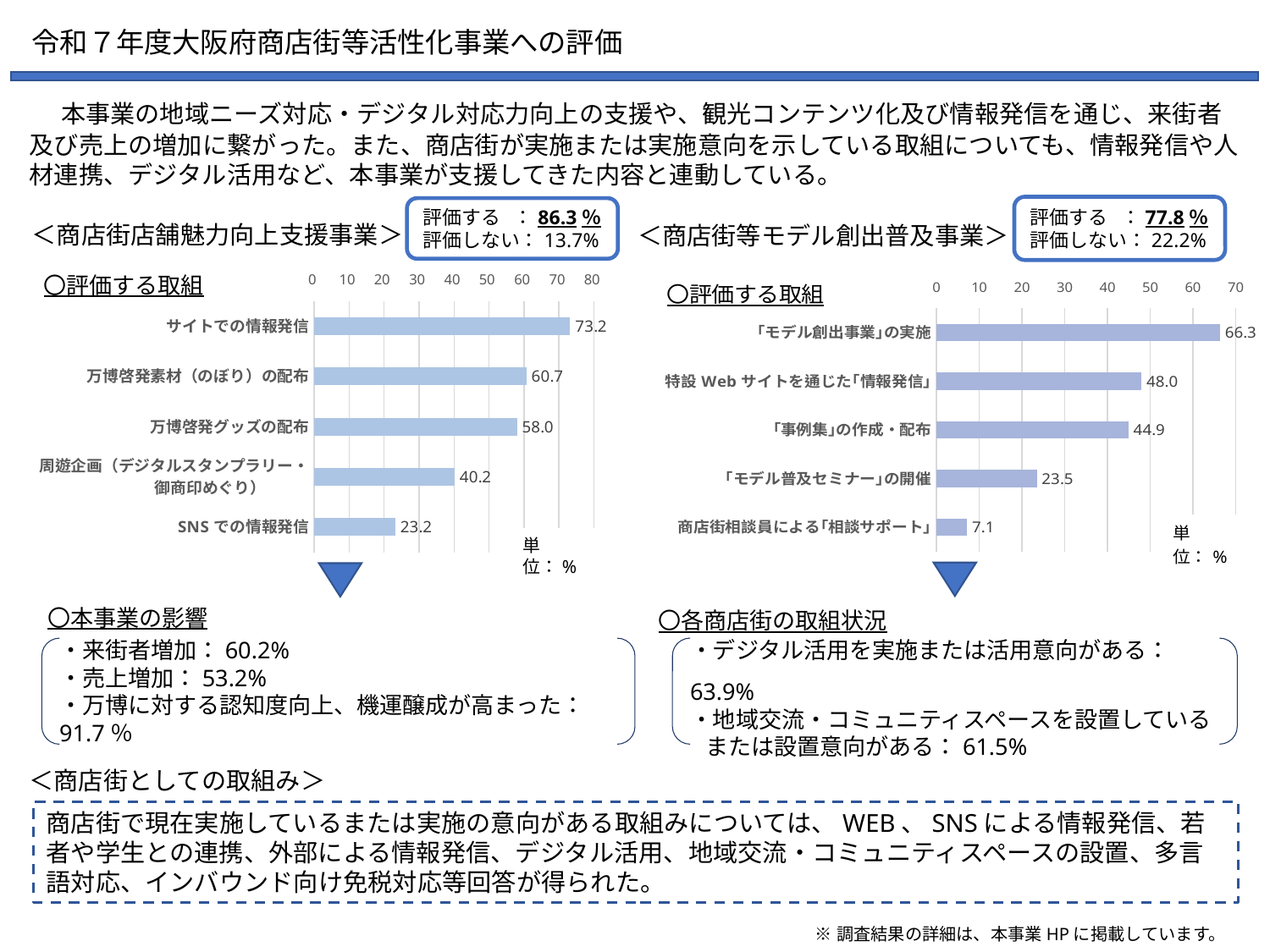
In the right chart, which category has the lowest value? 商店街相談員による「相談サポート」 In the left chart (商店街店舗魅力向上支援事業 評価する取組), what is the value for サイトでの情報発信? 73.2 In the left chart, which category has the highest value? サイトでの情報発信 In the left chart, what is the difference between 万博啓発素材（のぼり）の配布 and 万博啓発グッズの配布? 2.7 What type of chart is the right chart? Bar chart In the left chart, how many categories are plotted? 5 In the right chart, what is the difference between 「モデル創出事業」の実施 and 「事例集」の作成・配布? 21.4 In the left chart, what is the value for SNSでの情報発信? 23.2 In the right chart (商店街等モデル創出普及事業 評価する取組), what is the value for 「モデル創出事業」の実施? 66.3 What unit is indicated for the values in the left chart? % In the right chart, which is larger: 特設Webサイトを通じた「情報発信」 or 「モデル普及セミナー」の開催? 特設Webサイトを通じた「情報発信」 In the left chart, is the value for 周遊企画（デジタルスタンプラリー・御商印めぐり） greater or less than 50? less